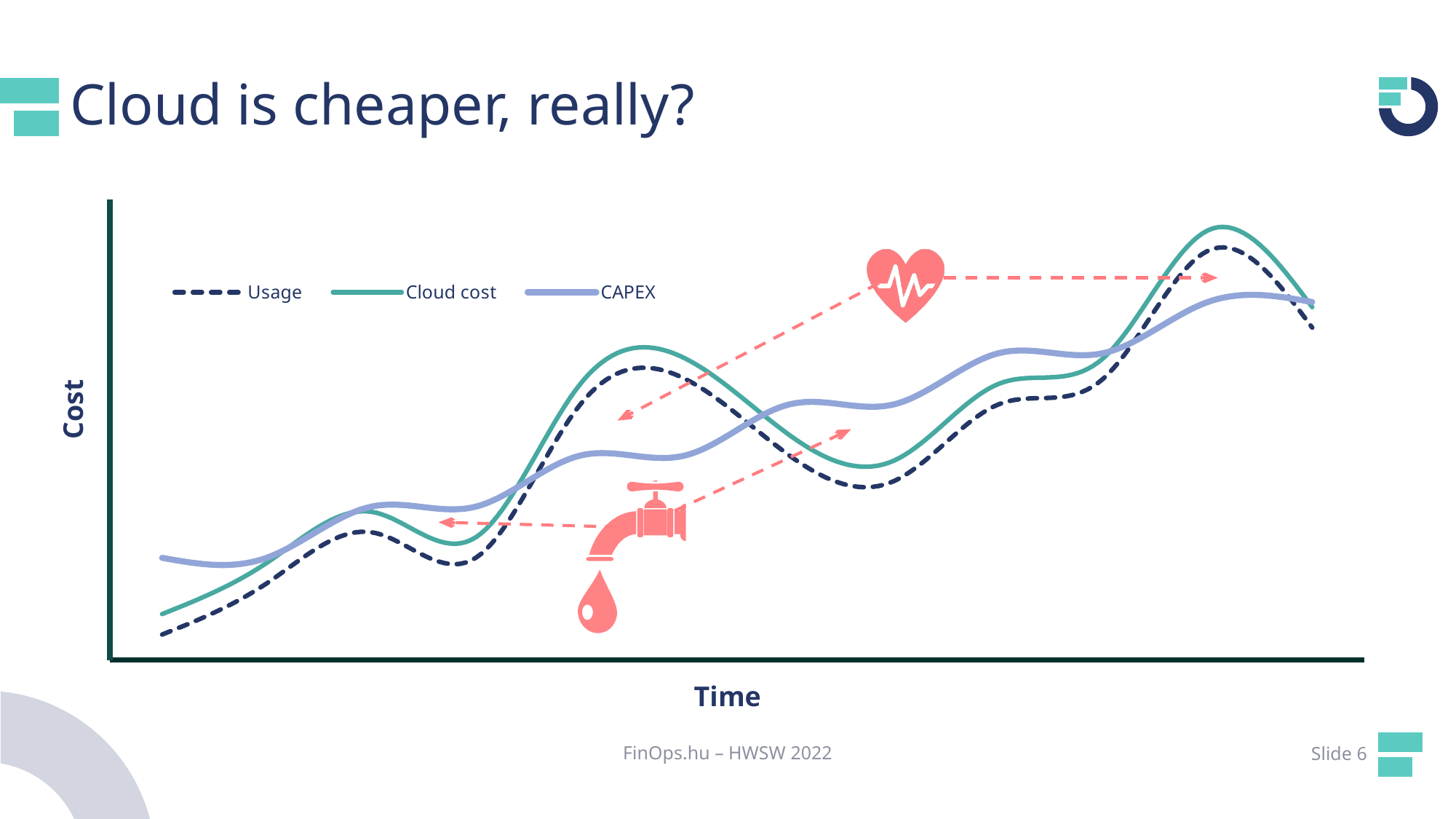
Which series in the chart is drawn with a dashed line? Usage At the start of the x axis, which is higher, CAPEX or Usage? CAPEX Does the Usage line generally rise or fall along the x axis? rise At the start of the x axis, which is higher, Cloud cost or Usage? Cloud cost Does the Cloud cost line generally rise or fall along the x axis? rise How many series does the chart's legend list? 3 What are the three series named in the chart's legend? Usage, Cloud cost, CAPEX What kind of chart is shown on the slide? line chart Does the CAPEX line generally rise or fall along the x axis? rise At the highest peak near the right of the chart, which is higher, Cloud cost or CAPEX? Cloud cost